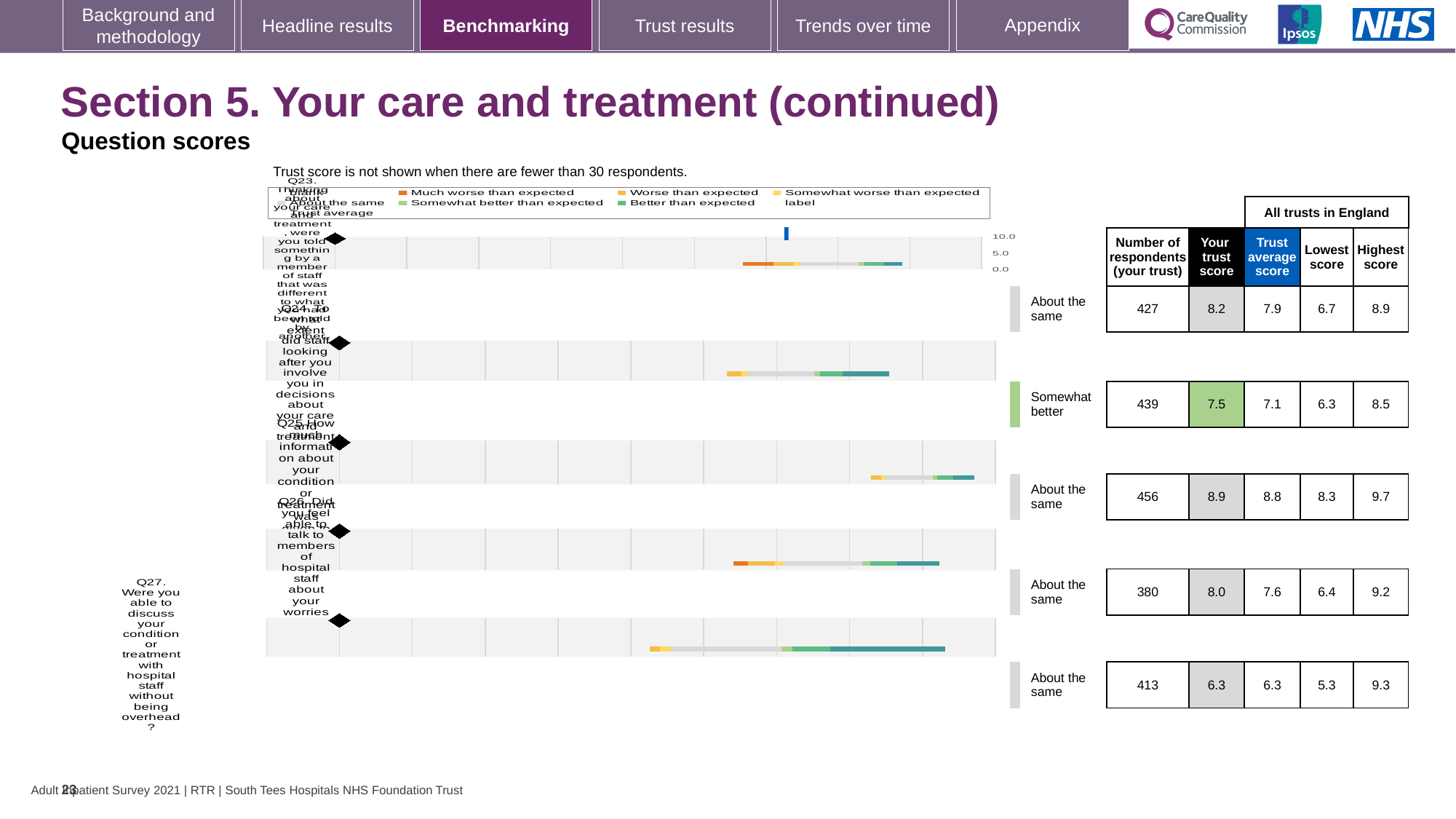
Which question has the highest 'Your trust score'? Q25 What is the trust average score for Q25? 8.8 For Q23, what is the difference between your trust score and the trust average score? 0.3 What is your trust score for Q24? 7.5 What is the lowest score across all trusts in England for Q27? 5.3 What kind of chart is used to show the question scores? Bar chart How many questions are shown on the slide? 5 Which question is rated 'Somewhat better' rather than 'About the same'? Q24 What is the highest score across all trusts in England for Q26? 9.2 How many respondents from your trust answered Q23? 427 Which question has the lowest 'Your trust score'? Q27 For Q24, which is larger: your trust score or the trust average score? Your trust score